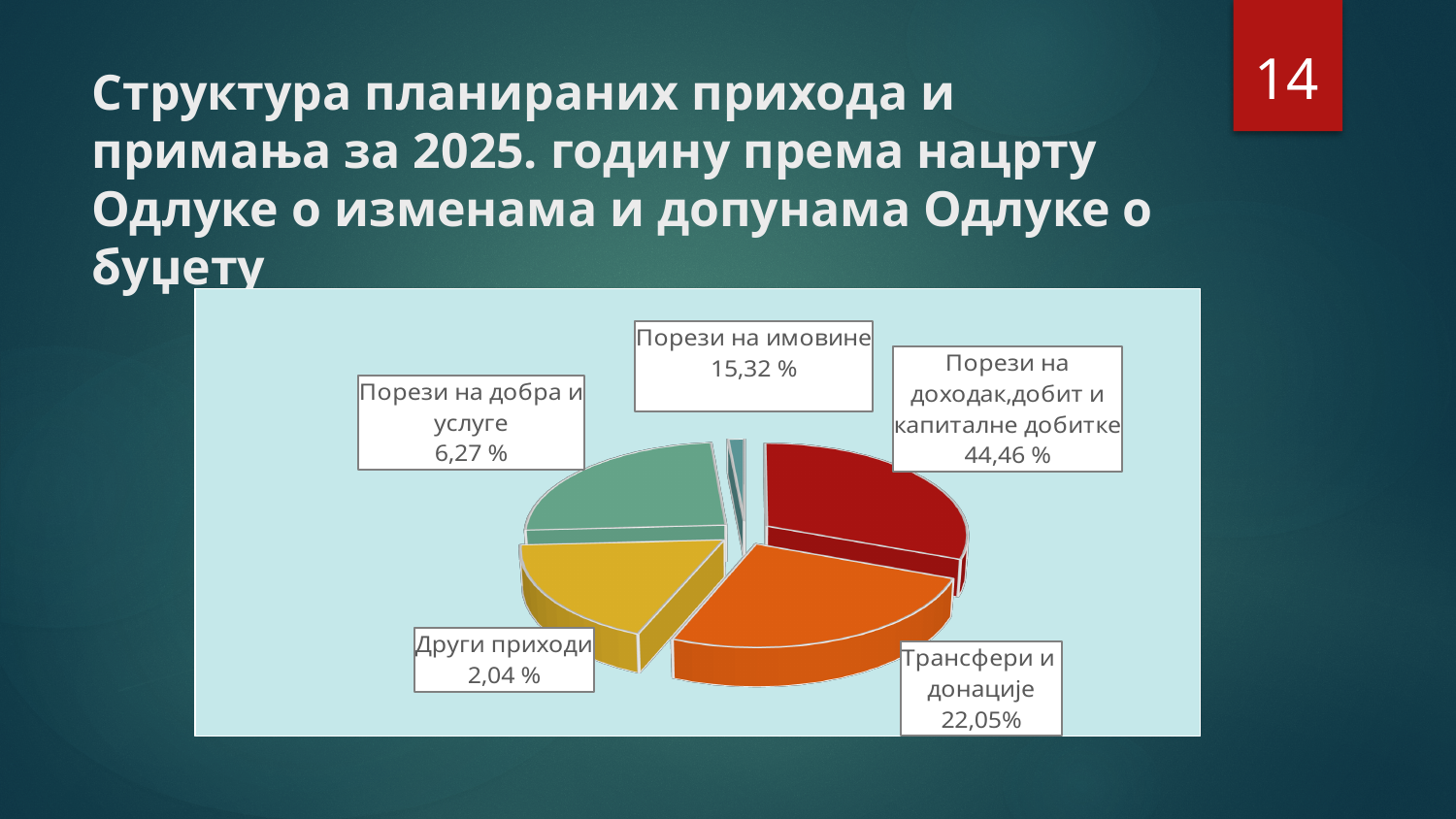
What share of the pie is labelled for "Трансфери и донације"? 22,05% Which is larger: the share for "Трансфери и донације" or the share for "Порези на имовине"? Трансфери и донације What is the difference in percentage points between "Порези на имовине" and "Порези на добра и услуге"? 9,05 What share of the pie is labelled for "Порези на доходак,добит и капиталне добитке"? 44,46 % What kind of chart is shown on the slide? pie chart Which labelled category has the smallest share of the pie? Други приходи What is the difference in percentage points between "Порези на доходак,добит и капиталне добитке" and "Трансфери и донације"? 22,41 Which labelled category has the largest share of the pie? Порези на доходак,добит и капиталне добитке What share of the pie is labelled for "Други приходи"? 2,04 % How many slices of the pie have a data label with a category name and percentage? 5 What share of the pie is labelled for "Порези на добра и услуге"? 6,27 % What share of the pie is labelled for "Порези на имовине"? 15,32 %